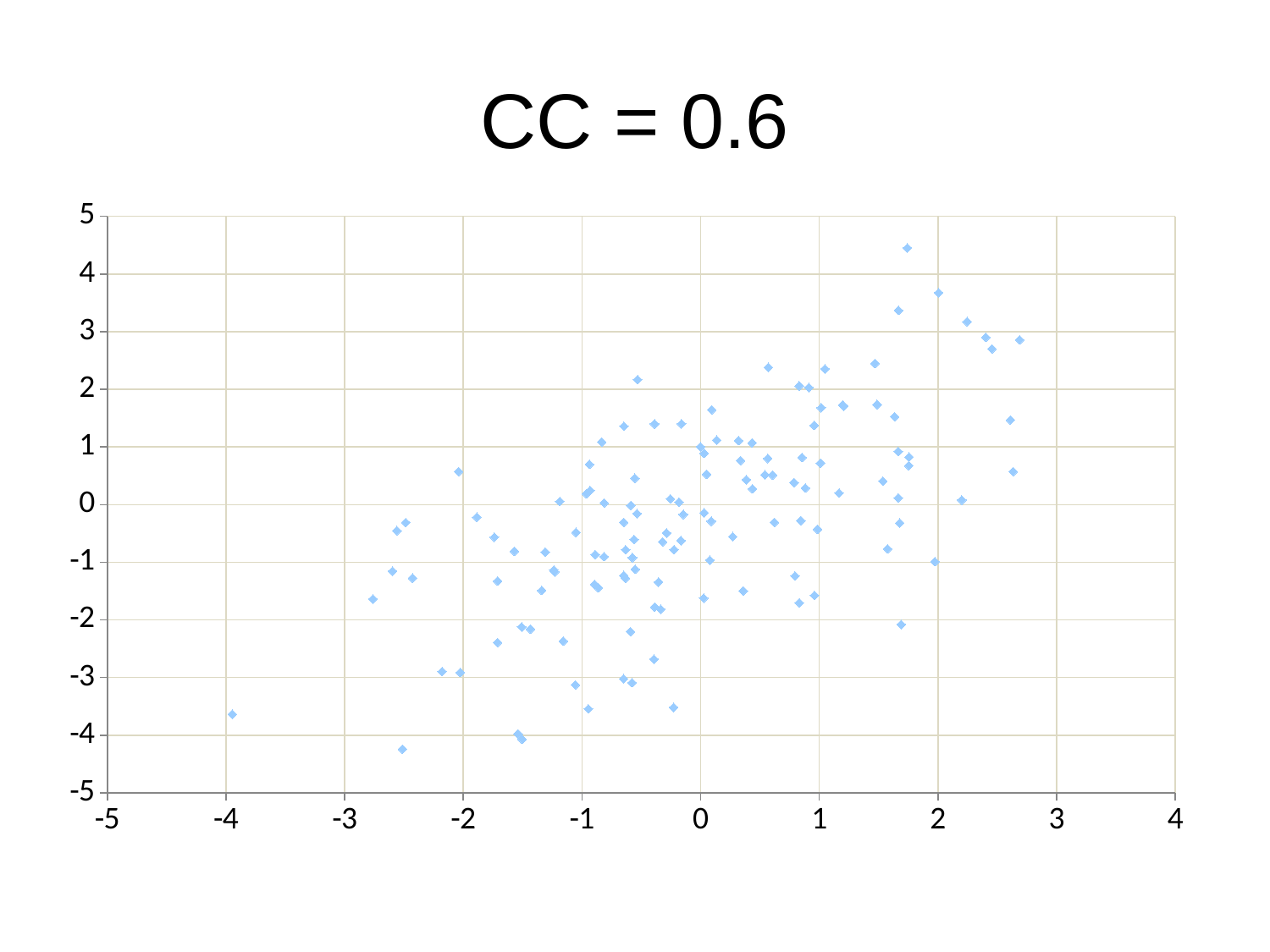
Is the y value of the highest point on the chart greater or less than 4? greater Do the y values generally rise or fall as x increases along the x axis? rise Is the x value of the highest point on the chart greater or less than 1? greater Is the x value of the rightmost point on the chart greater or less than 2? greater What is the maximum value shown on the x axis? 4 What is the title of the chart? CC = 0.6 What kind of chart is shown on the slide? scatter plot